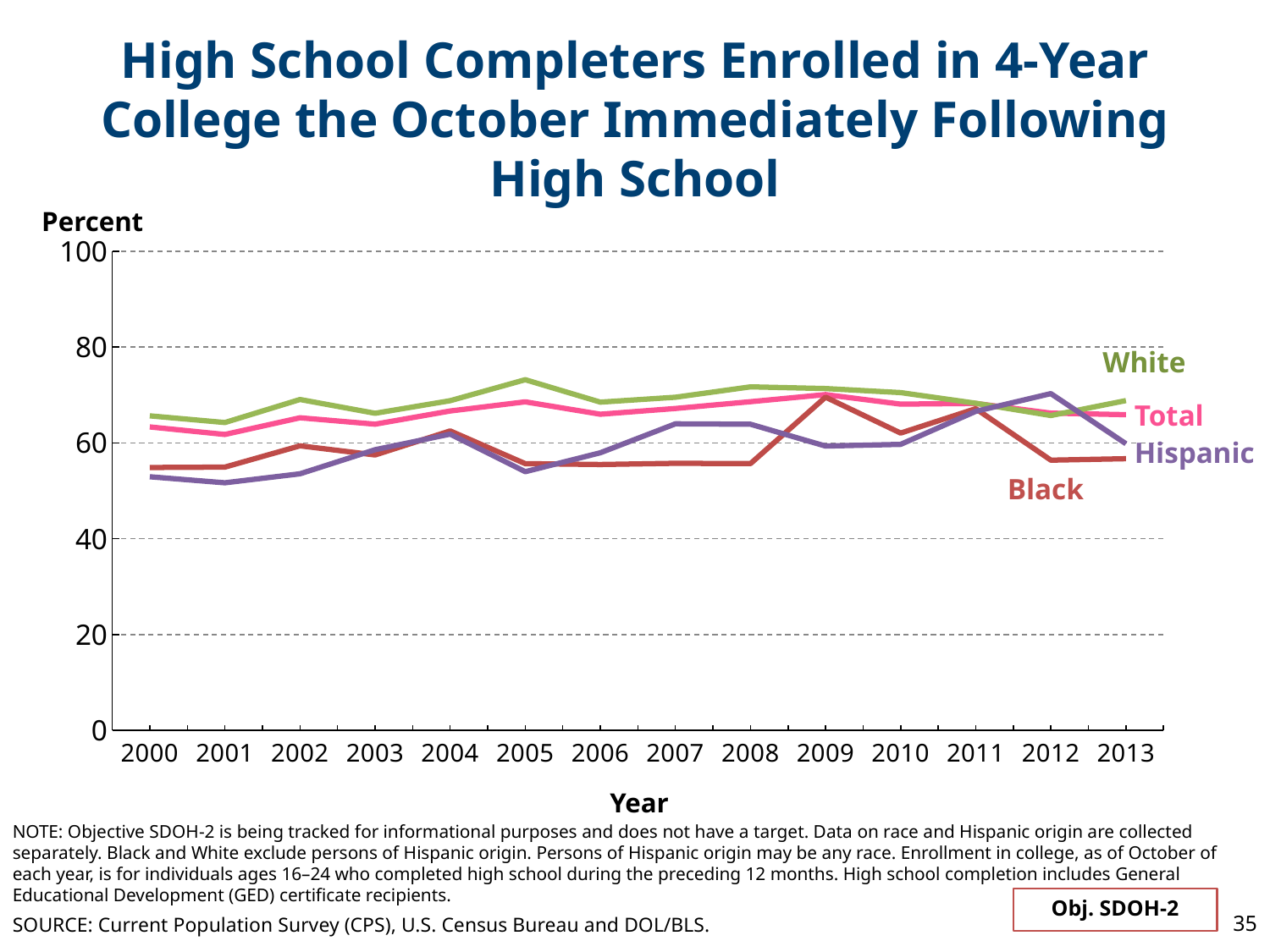
What kind of chart is shown on the slide? line chart Is the value for White in 2000 greater or less than 80? less Is the value for White in 2005 greater or less than 60? greater In 2012, which is larger, the value for Hispanic or the value for Black? Hispanic How many series (groups) are plotted on the chart? 4 Which group has the highest value in 2005? White Which group has the highest value in 2012? Hispanic In 2000, which is larger, the value for White or the value for Black? White What is the label on the x axis of the chart? Year Which group has the lowest value in 2001? Hispanic How many years are shown along the x axis? 14 Is the value for Hispanic in 2001 greater or less than 60? less